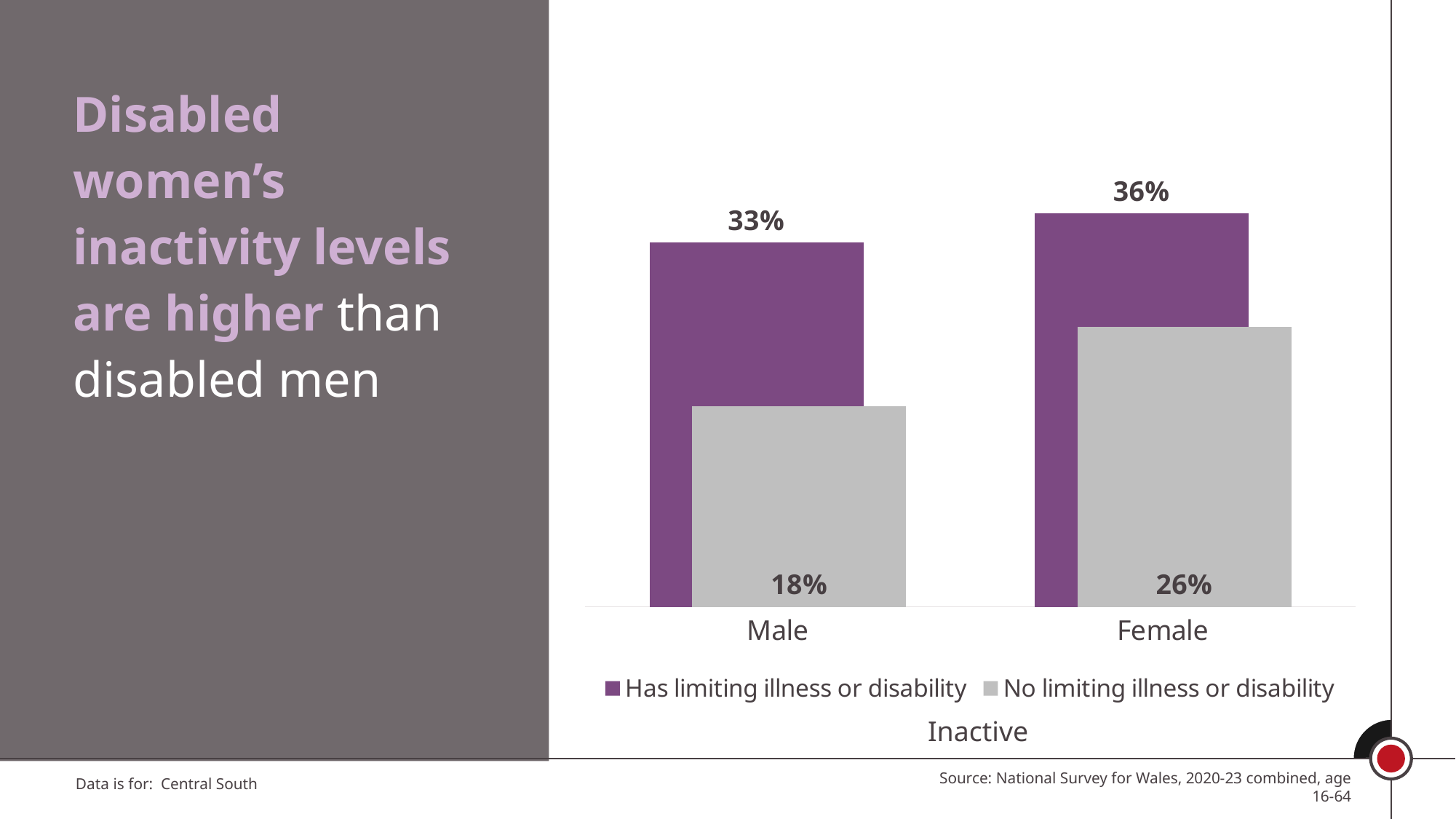
How many series does the chart legend list? 2 Is the inactivity value higher for males with a limiting illness or disability or for males without one? Males with a limiting illness or disability What is the inactivity value for males who have a limiting illness or disability? 33% What kind of chart is shown on the slide? Bar chart What is the inactivity value for males with no limiting illness or disability? 18% What is the difference between the inactivity values for females and males who have a limiting illness or disability? 3% What is the inactivity value for females who have a limiting illness or disability? 36% What is the difference between the inactivity values for females with and without a limiting illness or disability? 10% Which group has the lowest inactivity value on the chart? Male, No limiting illness or disability How many categories are shown on the x axis of the chart? 2 Which group has the highest inactivity value on the chart? Female, Has limiting illness or disability What is the inactivity value for females with no limiting illness or disability? 26%